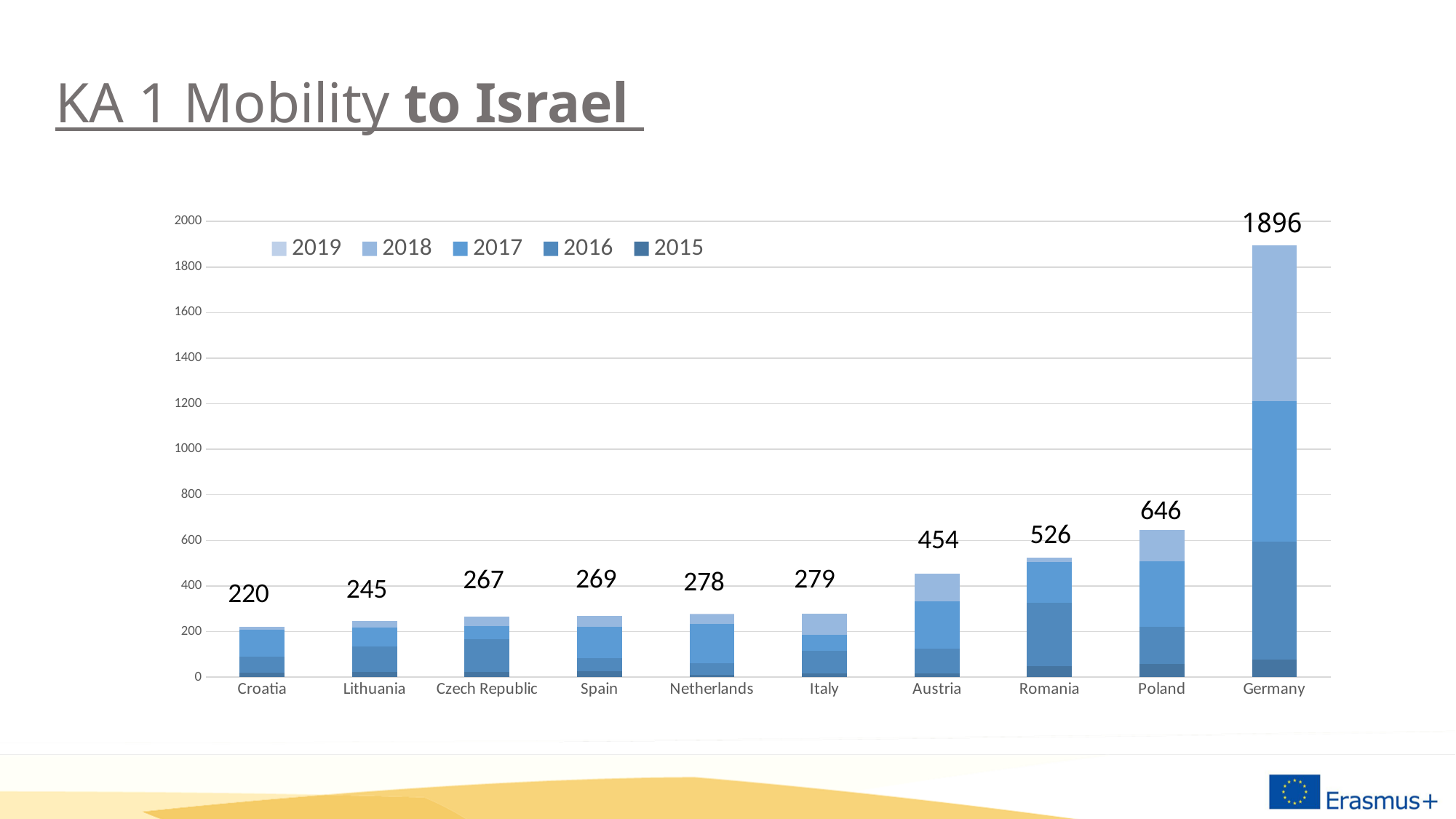
Which country has the lowest total? Croatia What is the total value shown for Germany? 1896 Is the total for Romania greater or less than 400? greater Which has a larger total, Austria or Lithuania? Austria How many countries are shown on the x axis? 10 How many series does the legend list? 5 What is the total value shown for Austria? 454 What is the difference between the totals for Poland and Romania? 120 What is the total value shown for Croatia? 220 Which country has the highest total? Germany What kind of chart is shown? Stacked bar chart Which years are listed in the legend? 2019, 2018, 2017, 2016, 2015